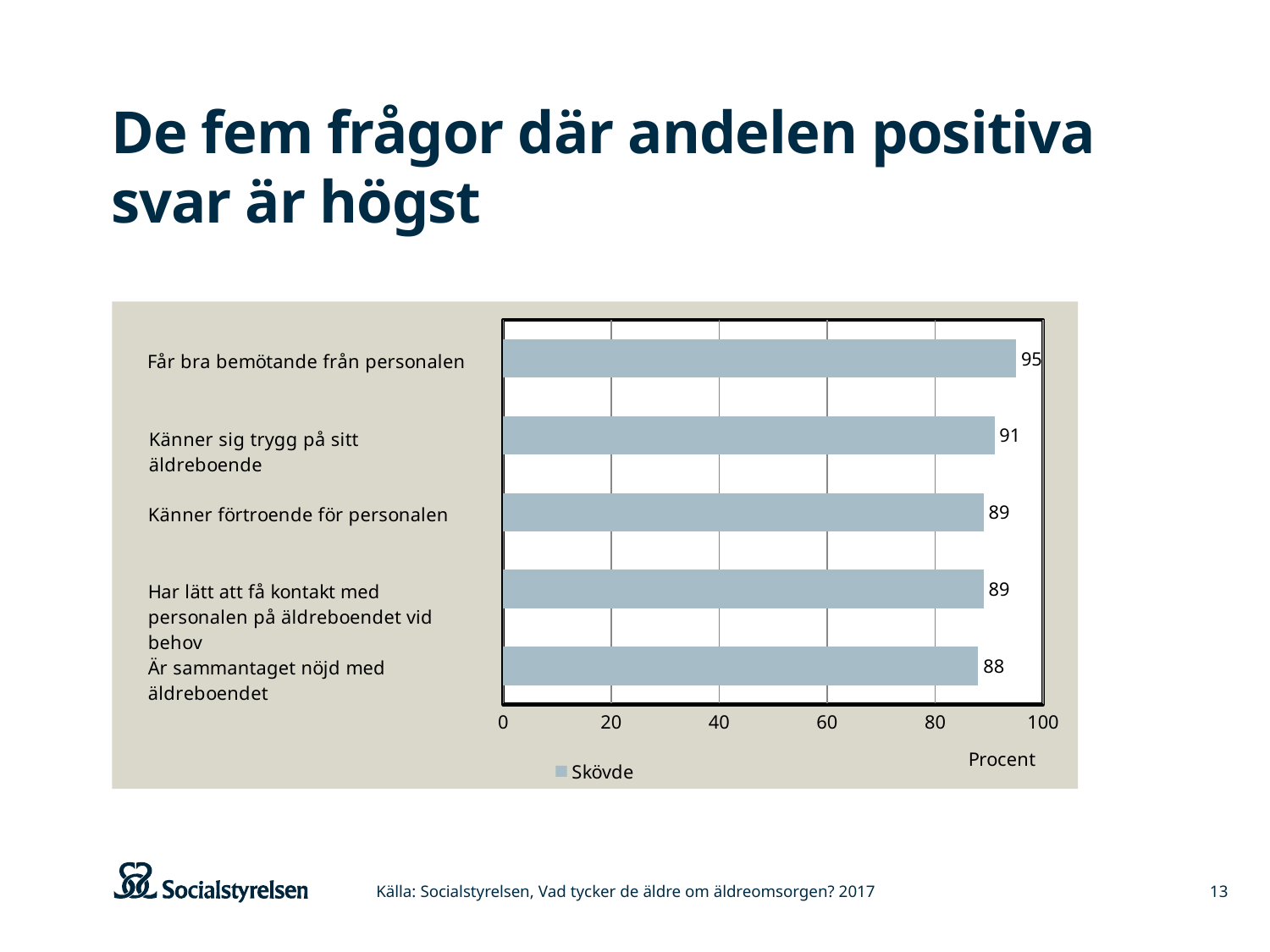
What is the value for "Får bra bemötande från personalen"? 95 What is the value for "Känner förtroende för personalen"? 89 What kind of chart is shown on the slide? Bar chart What is the value for "Känner sig trygg på sitt äldreboende"? 91 Which category has the lowest value? Är sammantaget nöjd med äldreboendet Which category has the highest value? Får bra bemötande från personalen How many series does the legend list? 1 How many categories are shown in the chart? 5 Which is larger: the value for "Känner sig trygg på sitt äldreboende" or the value for "Känner förtroende för personalen"? Känner sig trygg på sitt äldreboende What is the difference between the values for "Får bra bemötande från personalen" and "Är sammantaget nöjd med äldreboendet"? 7 What is the value for "Är sammantaget nöjd med äldreboendet"? 88 What is the name of the series shown in the legend? Skövde